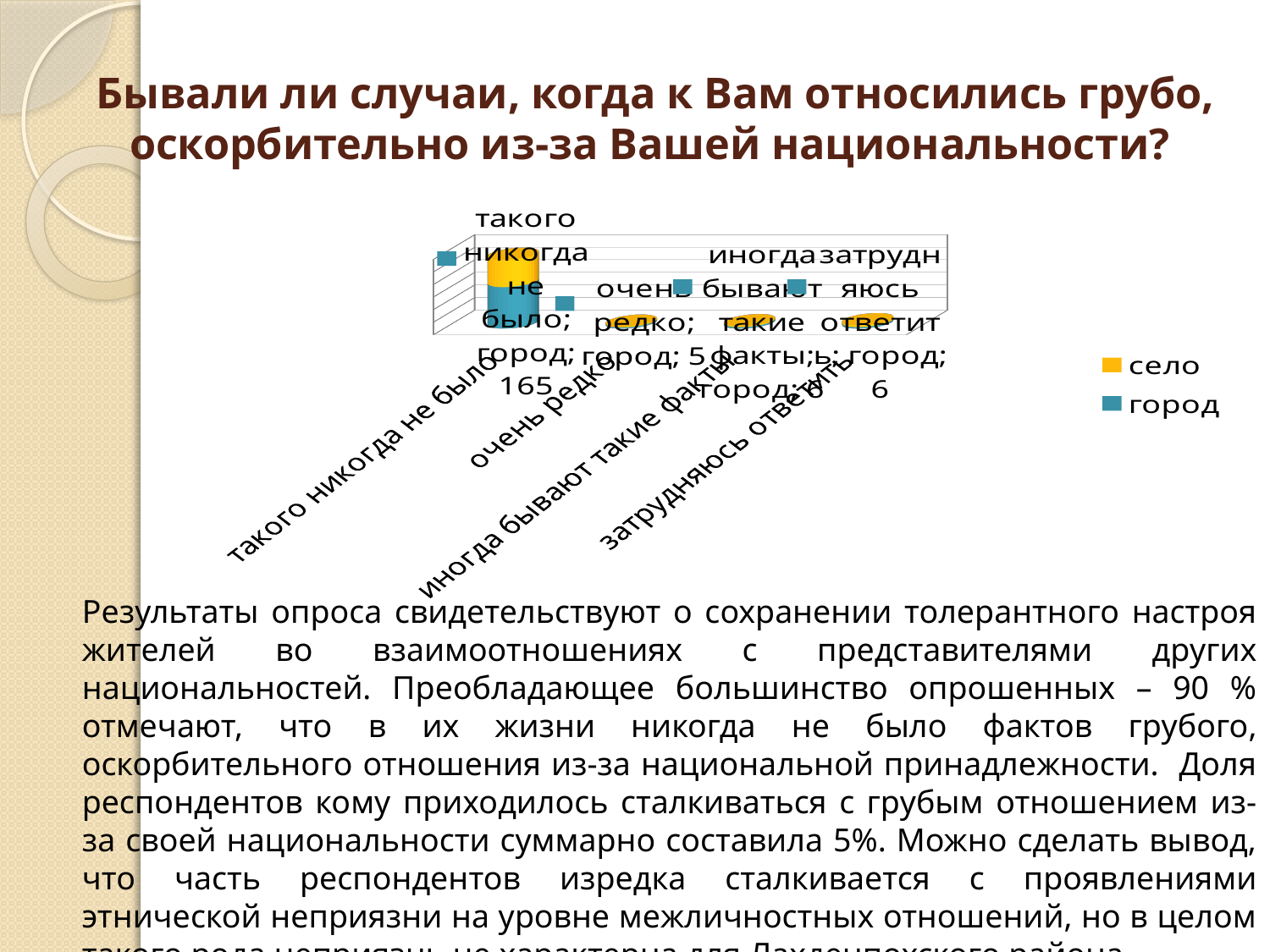
How many categories are shown on the chart's x axis? 4 What is the difference between the 'город' values for 'такого никогда не было' and 'затрудняюсь ответить'? 159 What is the value for 'город' in the category 'затрудняюсь ответить'? 6 For the series 'город', which is larger: 'такого никогда не было' or 'затрудняюсь ответить'? такого никогда не было How many series does the chart legend list? 2 Which colour represents the series 'город' in the chart? teal (blue-green) Which category has the highest bar in the chart? такого никогда не было What is the difference between the 'город' values for 'такого никогда не было' and 'очень редко'? 160 What is the value for 'город' in the category 'очень редко'? 5 What is the value for 'город' in the category 'такого никогда не было'? 165 What kind of chart is shown on the slide? bar chart What are the two series named in the chart legend? село, город